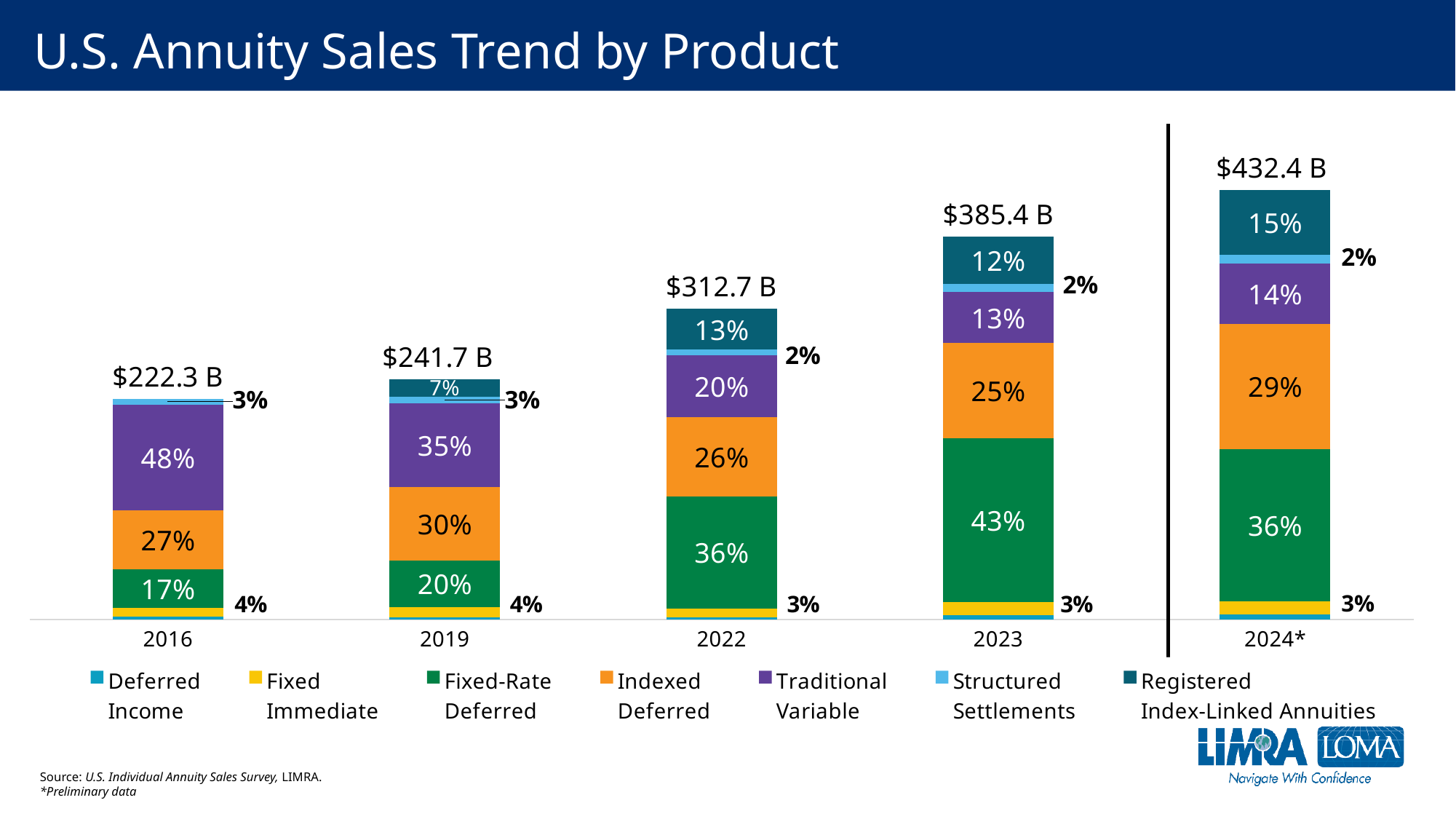
What is the total U.S. annuity sales value shown for 2023? $385.4 B Which year has the lowest total annuity sales? 2016 What share of 2023 sales was Fixed-Rate Deferred? 43% Which year has the highest total annuity sales? 2024* What percentage of 2016 sales was Traditional Variable? 48% What kind of chart is shown on the slide? Stacked bar chart How many product series does the legend list? 7 By how much did total annuity sales increase from 2023 to 2024*? $47.0 B How many years are shown on the x axis? 5 What percentage of 2024* sales was Indexed Deferred? 29% What share of 2019 sales was Registered Index-Linked Annuities? 7% Do the total annuity sales rise or fall from 2016 to 2024*? Rise